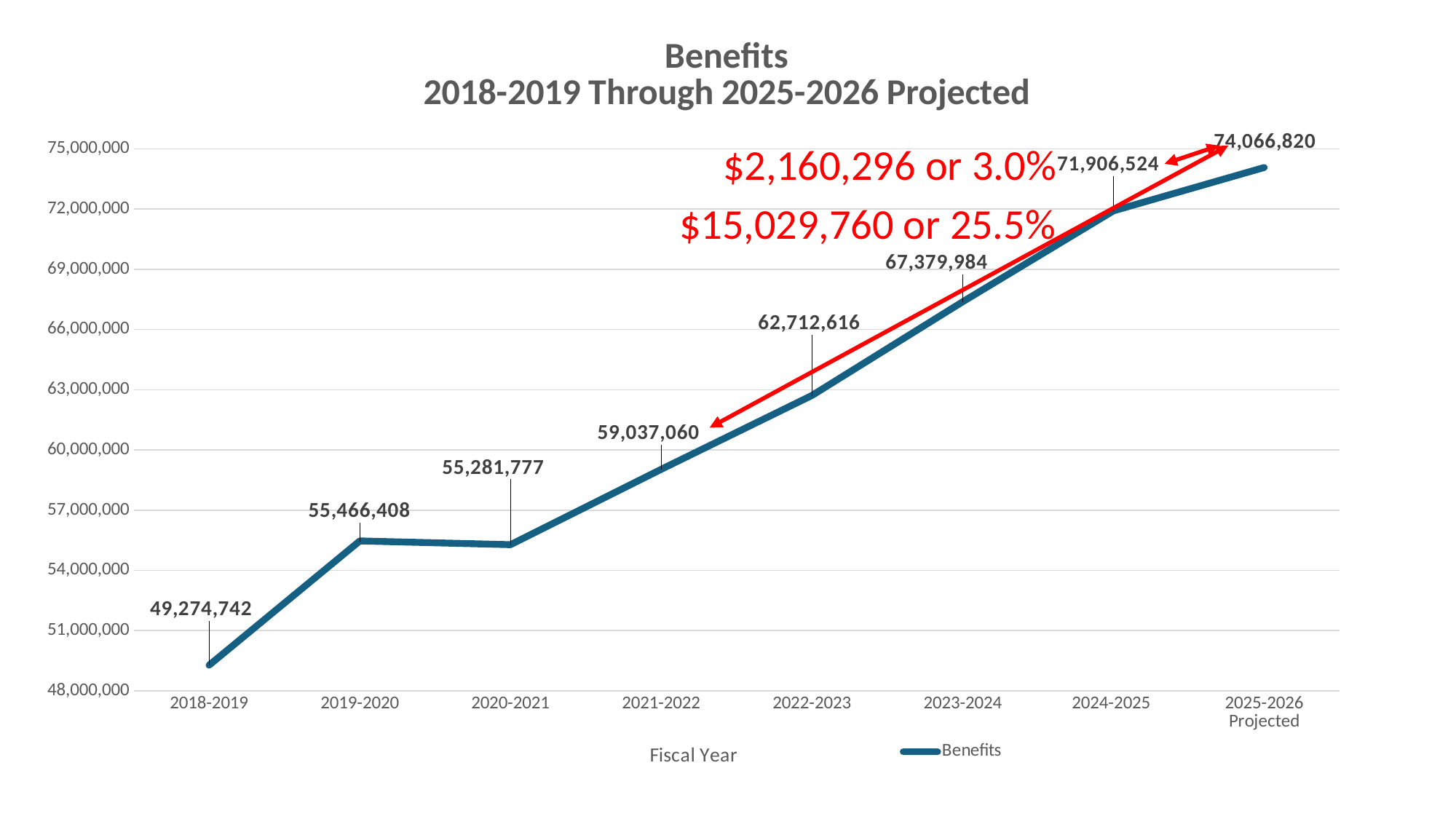
What is the difference between the Benefits values for 2025-2026 Projected and 2024-2025? 2,160,296 What is the difference between the Benefits values for 2023-2024 and 2022-2023? 4,667,368 Which fiscal year has the lowest Benefits value? 2018-2019 What is the Benefits value for 2018-2019? 49,274,742 Is the Benefits value for 2021-2022 greater or less than 60,000,000? less Which is larger, the Benefits value for 2019-2020 or for 2020-2021? 2019-2020 What is the Benefits value for 2022-2023? 62,712,616 How many fiscal years are plotted on the chart? 8 Which fiscal year has the highest Benefits value? 2025-2026 Projected What is the label of the x axis? Fiscal Year What kind of chart is shown on the slide? line chart What is the projected Benefits value for 2025-2026? 74,066,820